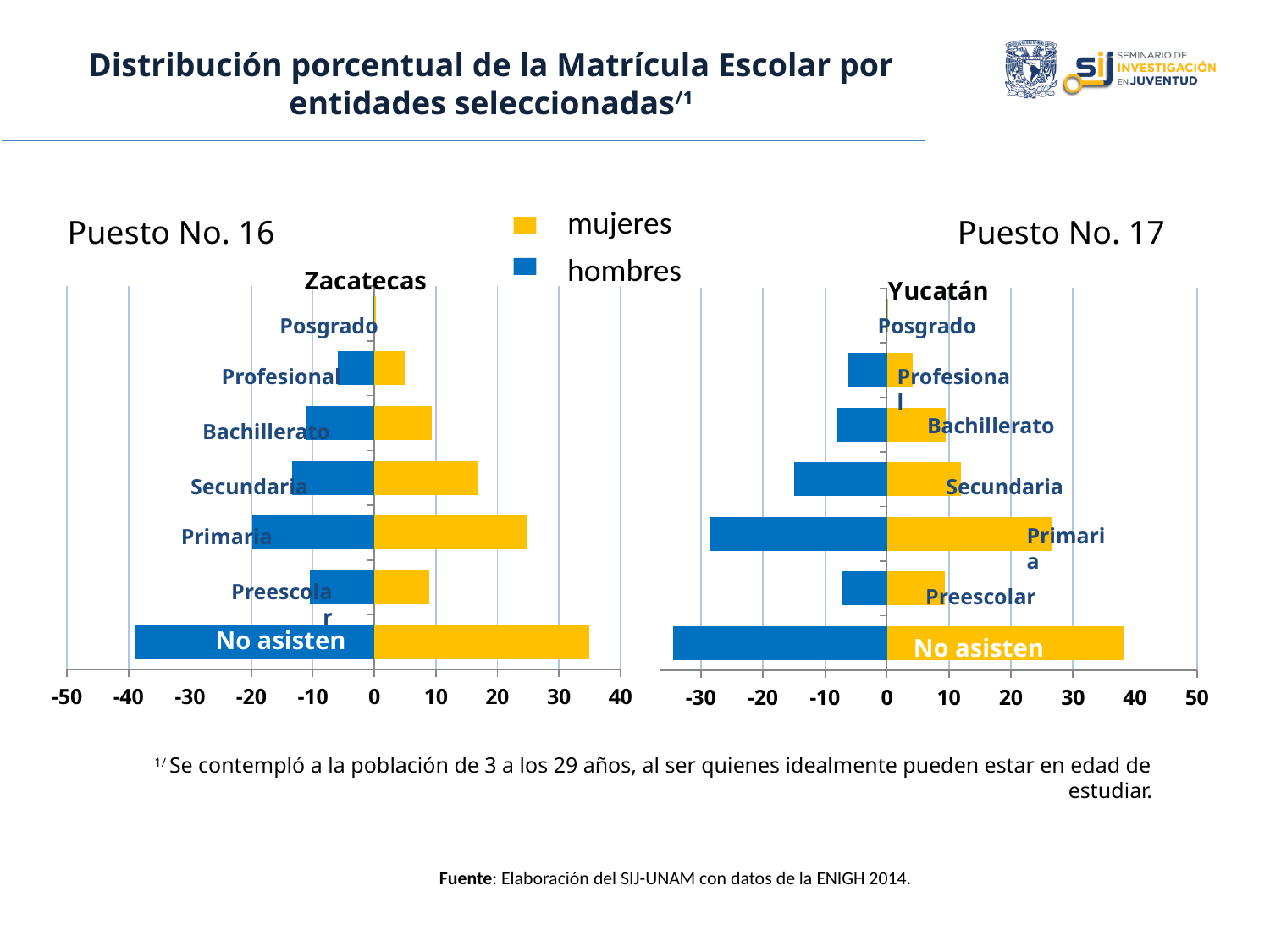
In the Yucatán chart, which category has the smallest value for mujeres? Posgrado In the Zacatecas chart, which category has the largest value for mujeres? No asisten In the Zacatecas chart, which is larger for mujeres: Primaria or Secundaria? Primaria How many categories are shown on the Yucatán chart? 7 In the Yucatán chart, is the mujeres value for No asisten greater or less than 30? greater In the Zacatecas chart, is the mujeres value for No asisten greater or less than 30? greater Which colour represents hombres in the legend? blue What kind of chart is used for Zacatecas? bar chart In the Zacatecas chart, is the mujeres value for Primaria greater or less than 20? greater How many series does the legend list? 2